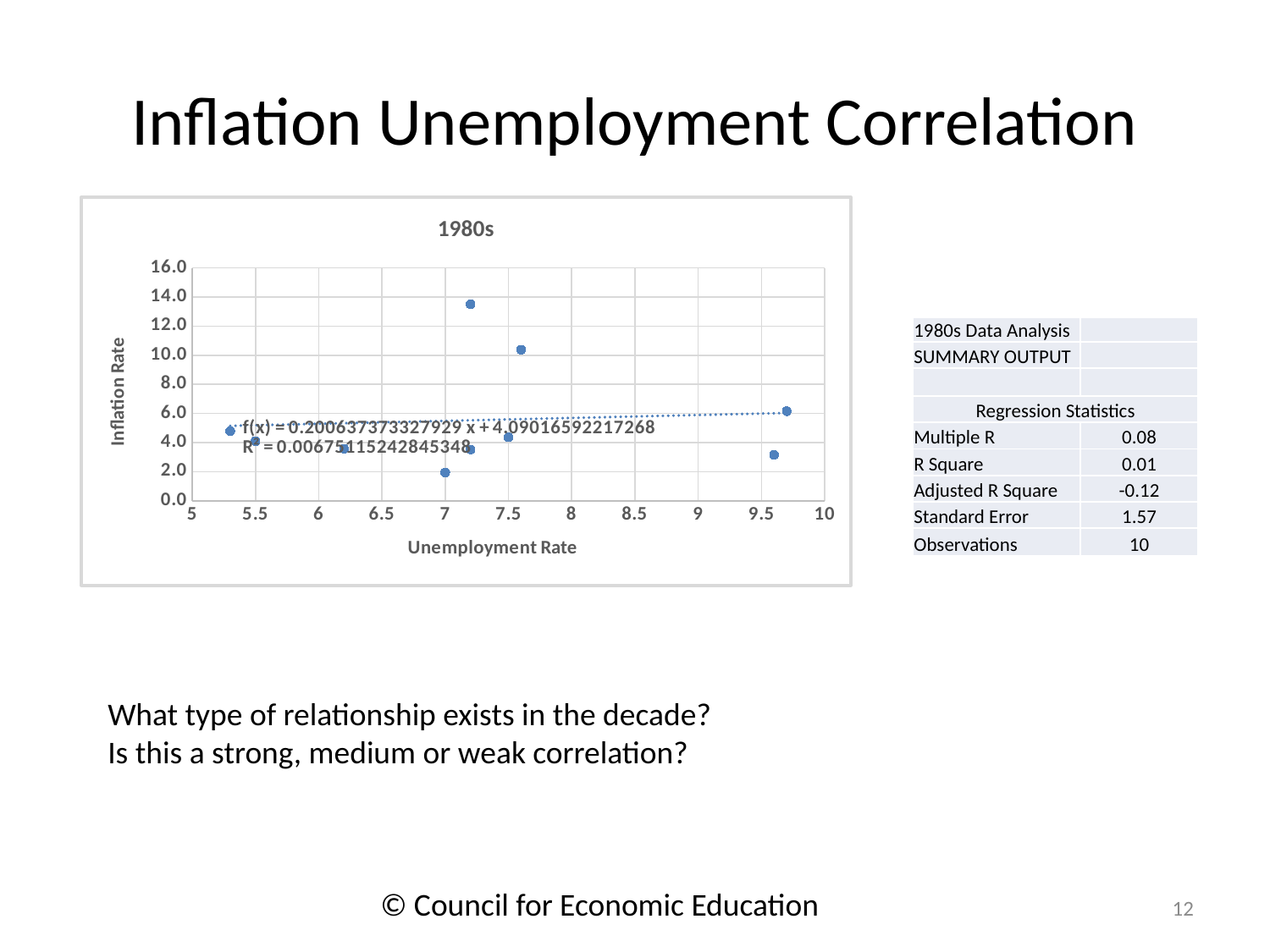
Is the inflation rate of the lowest point on the chart greater or less than 4.0? less Is the unemployment rate of the highest inflation point greater or less than 7? greater How many data points are plotted on the chart? 10 Is the inflation rate of the highest point on the chart greater or less than 12.0? greater Does the dotted trendline on the chart rise or fall as the unemployment rate increases? rise What is the title of the chart? 1980s What kind of chart is shown on the slide? Scatter chart What is the highest value shown on the y axis of the chart? 16.0 What is the label of the x axis of the chart? Unemployment Rate Which has the higher inflation rate: the point at an unemployment rate of about 7.2 near the top of the chart, or the point at about 7.6? The point at about 7.2